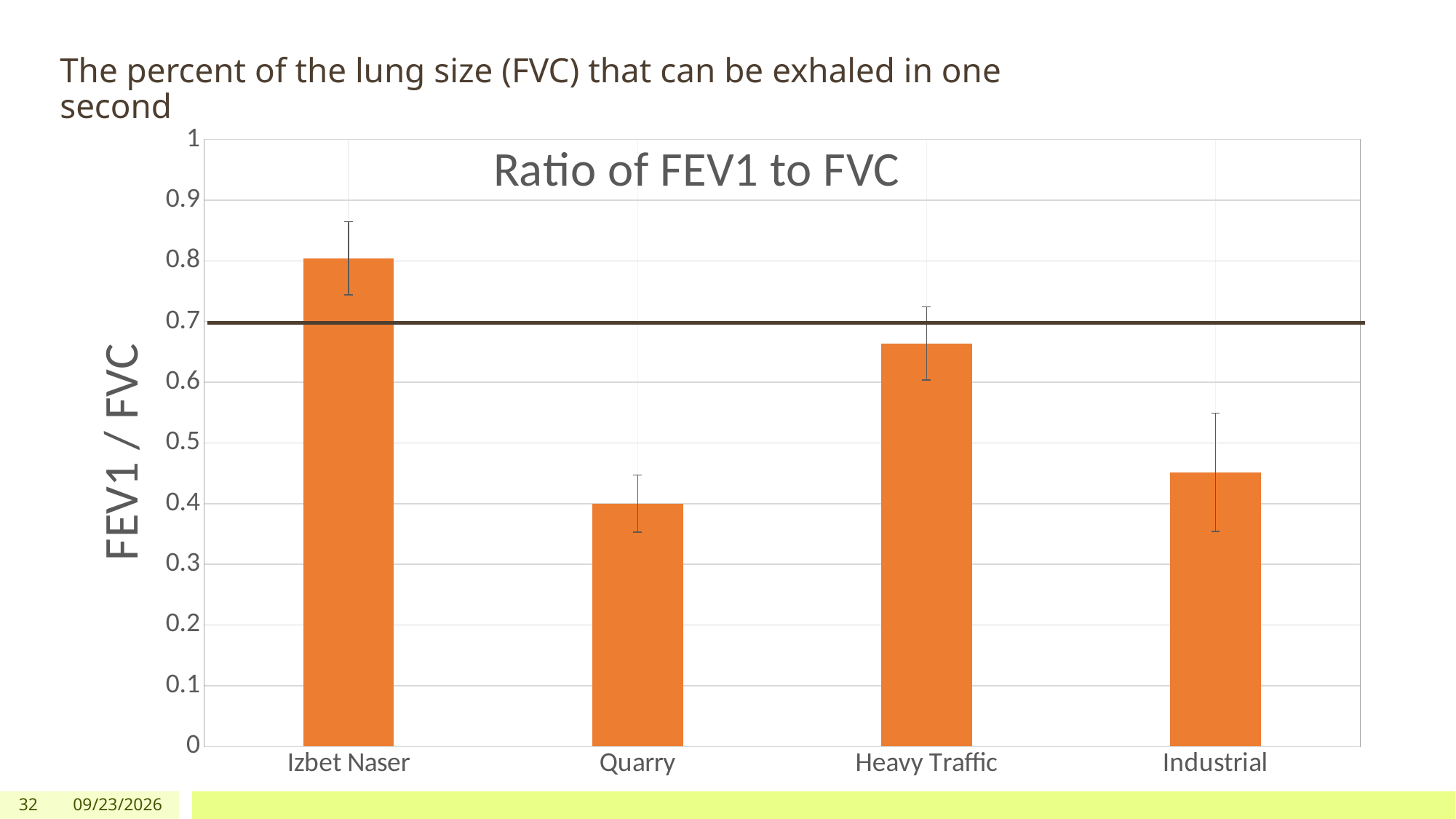
Which has a larger FEV1 / FVC ratio, Izbet Naser or Quarry? Izbet Naser Which has a larger FEV1 / FVC ratio, Heavy Traffic or Industrial? Heavy Traffic What is the title of the chart? Ratio of FEV1 to FVC How many categories are plotted on the x axis of the chart? 4 Which category has the lowest FEV1 / FVC ratio? Quarry Is the value for Industrial greater or less than 0.5? less Which category has the highest FEV1 / FVC ratio? Izbet Naser Is the value for Quarry greater or less than 0.5? less Is the value for Heavy Traffic greater or less than 0.7? less What kind of chart is shown on the slide? bar chart What is the label on the y axis of the chart? FEV1 / FVC